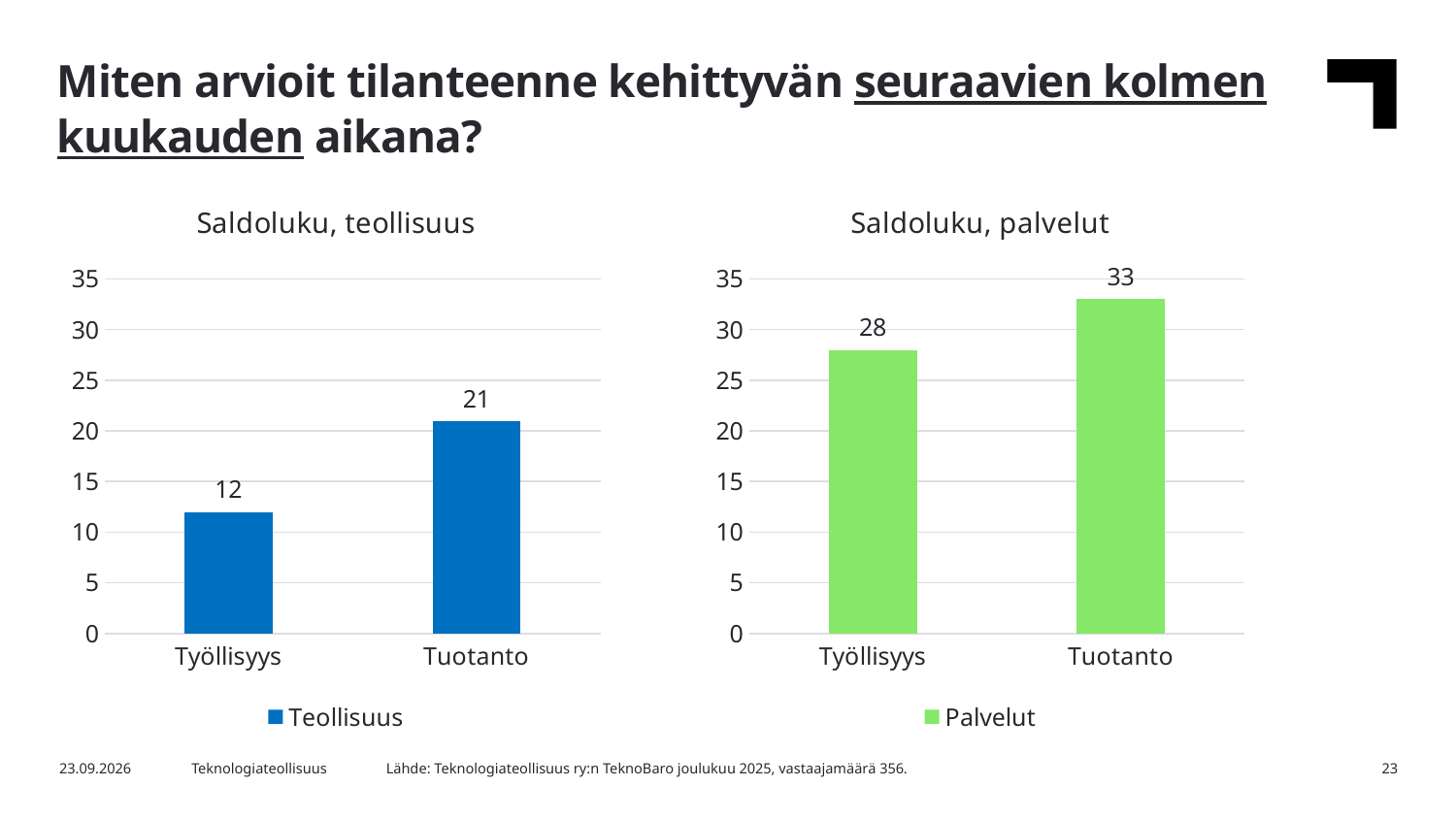
In the chart titled "Saldoluku, teollisuus", what is the value for Tuotanto? 21 What kind of chart is the chart titled "Saldoluku, palvelut"? Bar chart In the chart titled "Saldoluku, teollisuus", what is the difference between the values for Tuotanto and Työllisyys? 9 In the chart titled "Saldoluku, palvelut", what series name does the legend show? Palvelut Which is larger: the value for Tuotanto in the chart titled "Saldoluku, teollisuus" or the value for Työllisyys in the chart titled "Saldoluku, palvelut"? Työllisyys in Saldoluku, palvelut In the chart titled "Saldoluku, palvelut", what is the difference between the values for Tuotanto and Työllisyys? 5 In the chart titled "Saldoluku, teollisuus", what is the value for Työllisyys? 12 In the chart titled "Saldoluku, teollisuus", which category has the highest value? Tuotanto In the chart titled "Saldoluku, palvelut", what is the value for Tuotanto? 33 In the chart titled "Saldoluku, teollisuus", how many categories are shown on the x axis? 2 In the chart titled "Saldoluku, palvelut", what is the value for Työllisyys? 28 In the chart titled "Saldoluku, palvelut", which category has the lowest value? Työllisyys